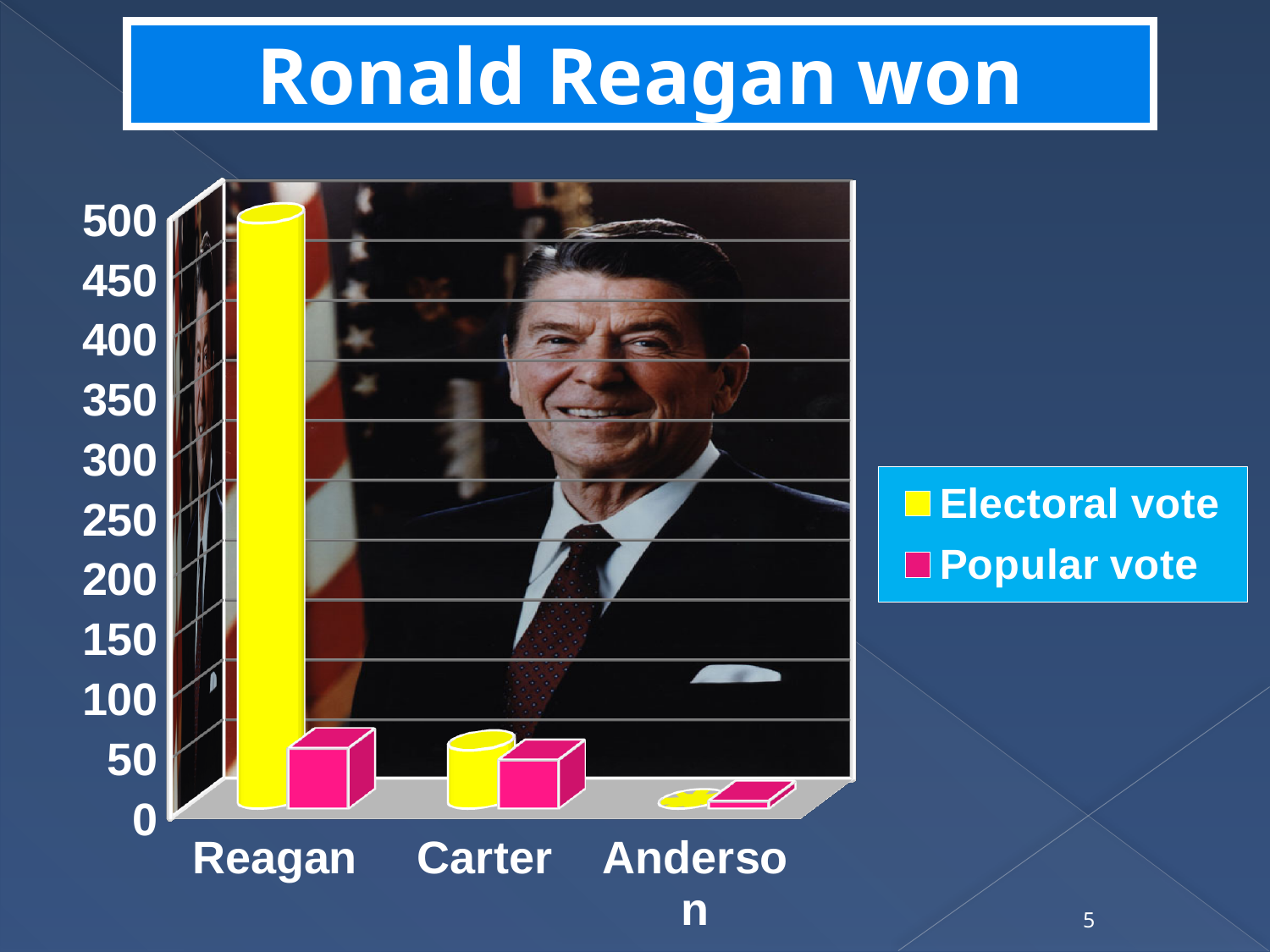
How many series does the chart legend list? 2 What colour represents the Electoral vote series in the chart legend? yellow How many candidates are shown on the x axis of the chart? 3 Which is larger, the Popular vote for Carter or the Popular vote for Anderson? Carter Is the Electoral vote value for Reagan greater or less than 400? greater Which candidate has the lowest Popular vote bar? Anderson Is the Electoral vote value for Carter greater or less than 100? less Is the Popular vote value for Anderson greater or less than 50? less What is the title of the slide containing the chart? Ronald Reagan won Which candidate has the highest Electoral vote bar? Reagan What type of chart is shown on the slide? bar chart Which is larger, the Electoral vote for Reagan or the Electoral vote for Carter? Reagan